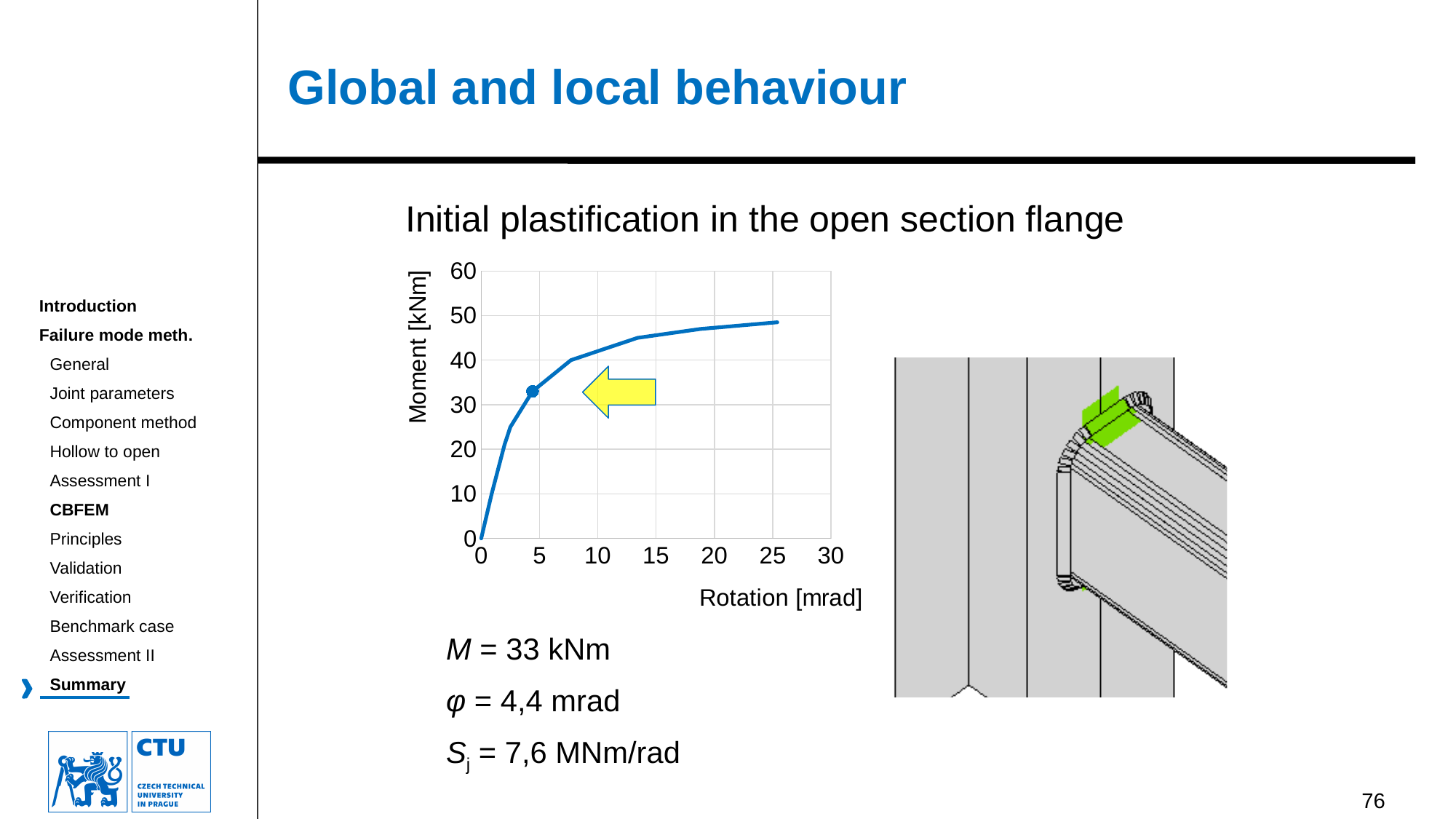
Is the moment at a rotation of 15 mrad greater or less than 40? greater What moment value corresponds to the marked point on the curve? 33 kNm Does the moment rise or fall as rotation increases along the x axis? rise What is the highest value shown on the vertical axis of the chart? 60 Is the moment at a rotation of 5 mrad greater or less than 30? greater Is the moment at a rotation of 2 mrad greater or less than 30? less What is the label of the vertical axis of the chart? Moment [kNm] What is the label of the horizontal axis of the chart? Rotation [mrad] How many curves are plotted on the chart? 1 What kind of chart is shown on the slide? line chart At what rotation is the marked point on the curve located? 4,4 mrad